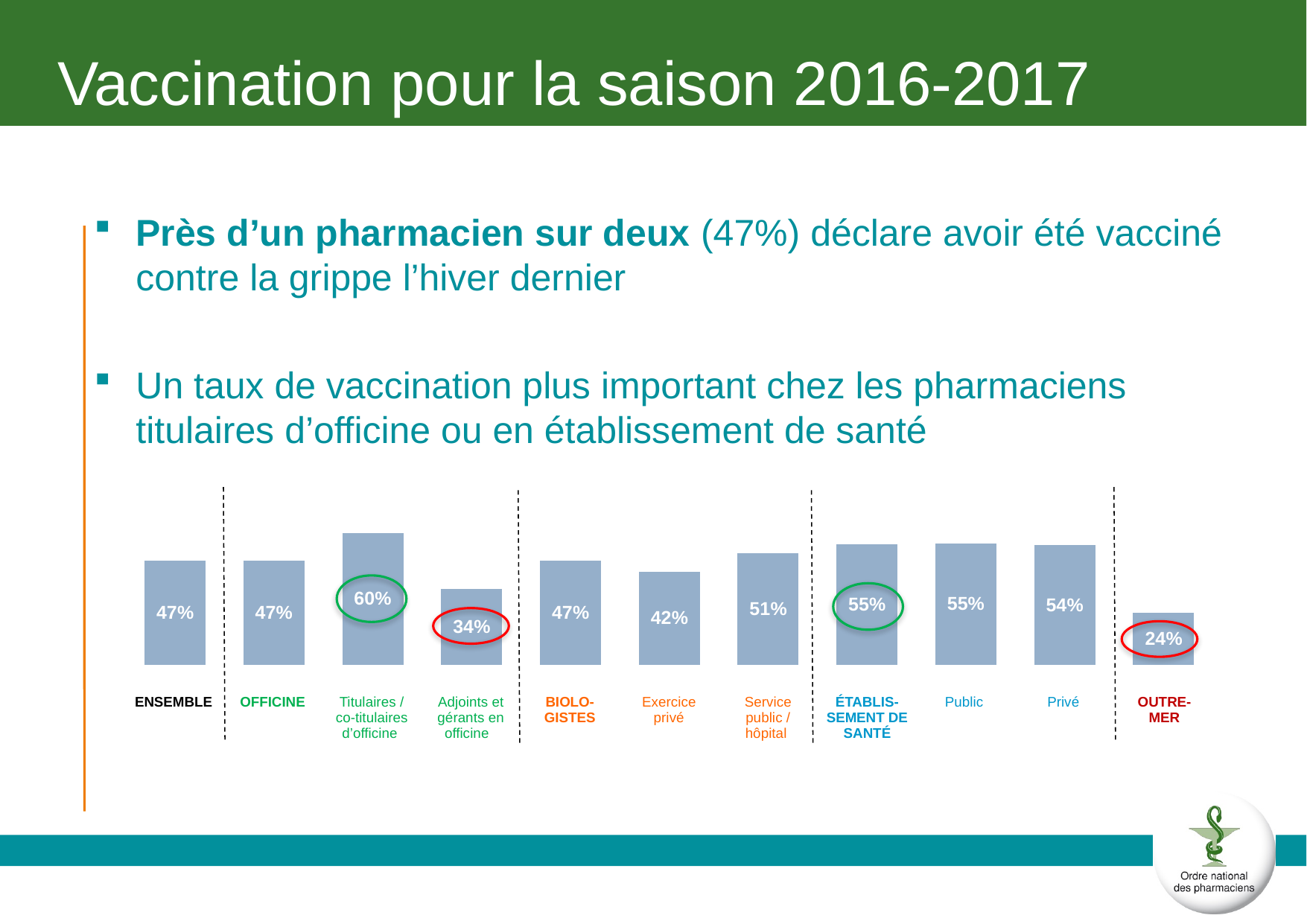
How many bars are shown in the chart? 11 Which is larger, the value for Service public / hôpital or the value for Exercice privé? Service public / hôpital What is the value shown for Titulaires / co-titulaires d'officine? 60% Which category has the lowest value in the chart? OUTRE-MER What is the value shown for OUTRE-MER? 24% What is the difference between the values for ÉTABLISSEMENT DE SANTÉ and OUTRE-MER? 31% What is the vaccination rate shown for ENSEMBLE? 47% What is the value shown for Adjoints et gérants en officine? 34% Which category has the highest value in the chart? Titulaires / co-titulaires d'officine What is the value shown for Exercice privé among biologistes? 42% What kind of chart is shown on the slide? Bar chart What is the difference between the values for Titulaires / co-titulaires d'officine and Adjoints et gérants en officine? 26%